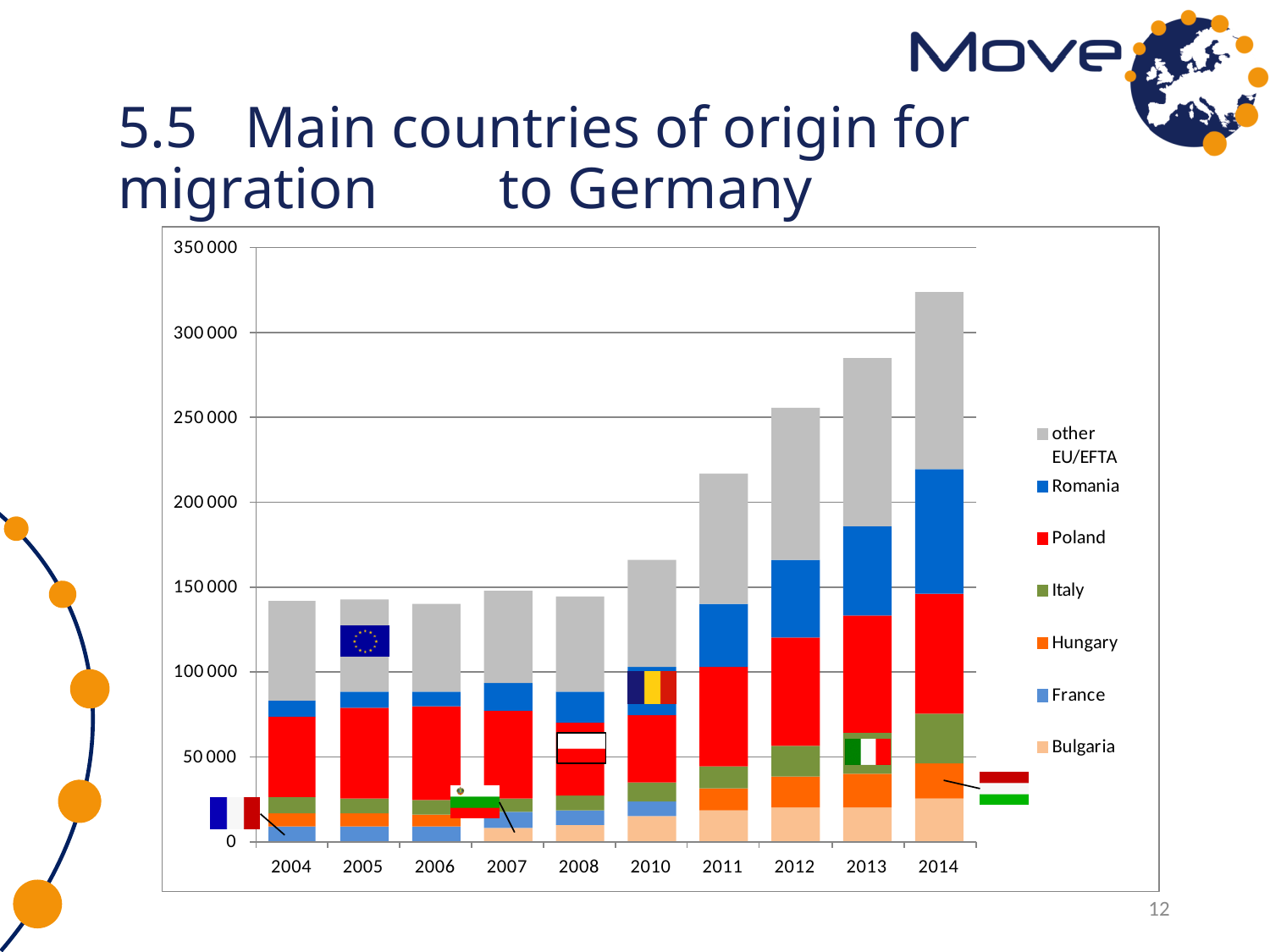
Which series is listed first (at the top) in the chart's legend? other EU/EFTA Do the total bar heights generally rise or fall from 2004 to 2014? rise Is the total height of the 2004 bar greater or less than 150 000? less How many years are shown along the x axis of the chart? 10 Which year has the tallest stacked bar in the chart? 2014 Is the total height of the 2013 bar greater or less than 250 000? greater What kind of chart is shown on the slide? stacked bar chart Is the total height of the 2010 bar greater or less than 150 000? greater Which series is shown in red in the chart? Poland How many series does the chart's legend list? 7 Which bar is taller overall, 2011 or 2008? 2011